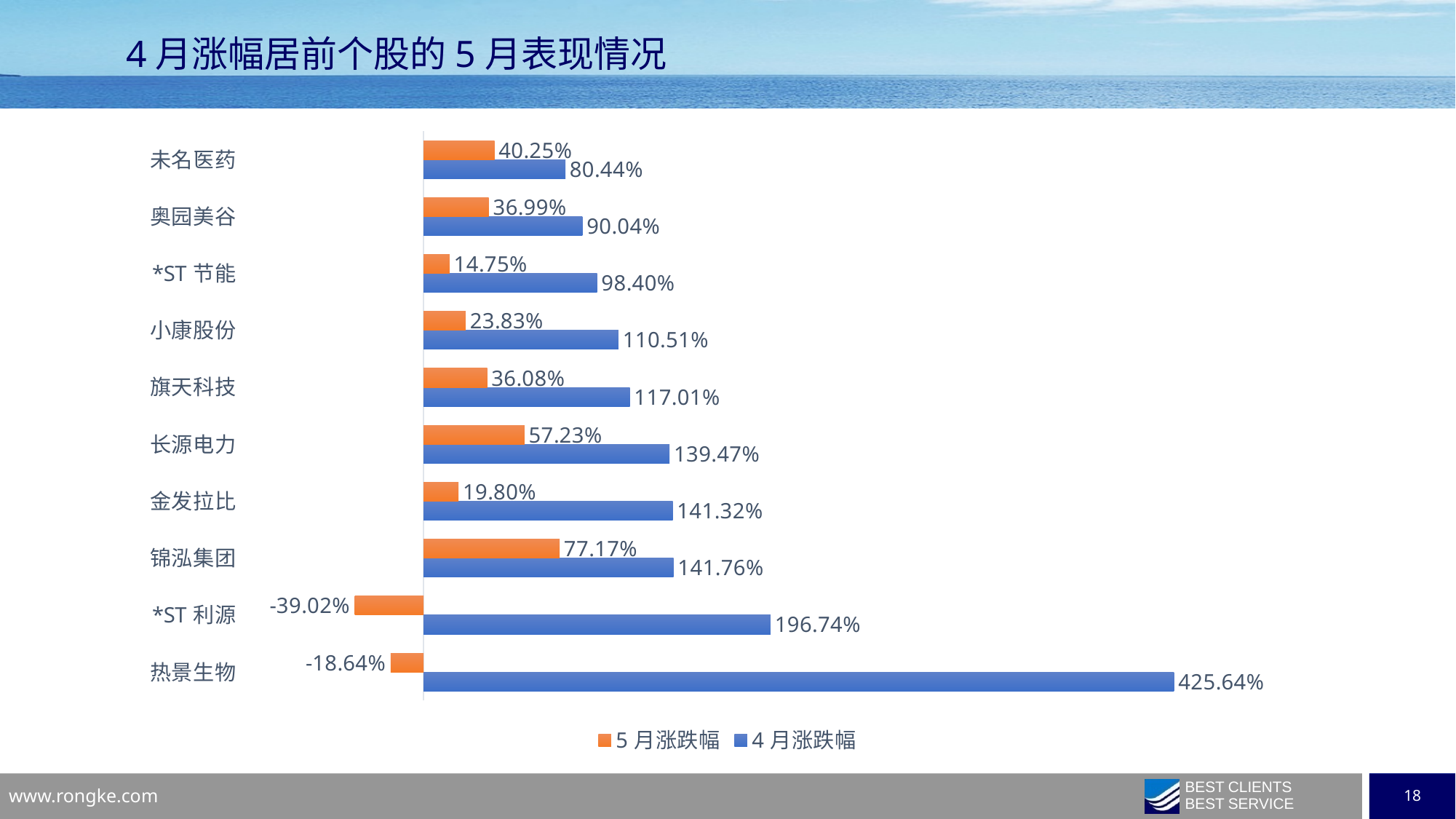
What is the 4月涨跌幅 value for 热景生物? 425.64% How many stocks are shown in the chart? 10 Which stock has the lowest 5月涨跌幅? *ST 利源 How many series does the legend list? 2 Which colour represents 4月涨跌幅 in the chart? Blue Which stock has the highest 4月涨跌幅? 热景生物 What is the title of the slide? 4月涨幅居前个股的5月表现情况 What kind of chart is shown on the slide? Bar chart What is the difference between the 4月涨跌幅 and 5月涨跌幅 values for 未名医药? 40.19% Which is larger, the 5月涨跌幅 for 长源电力 or for 旗天科技? 长源电力 What is the 5月涨跌幅 value for *ST 利源? -39.02% What is the 5月涨跌幅 value for 锦泓集团? 77.17%